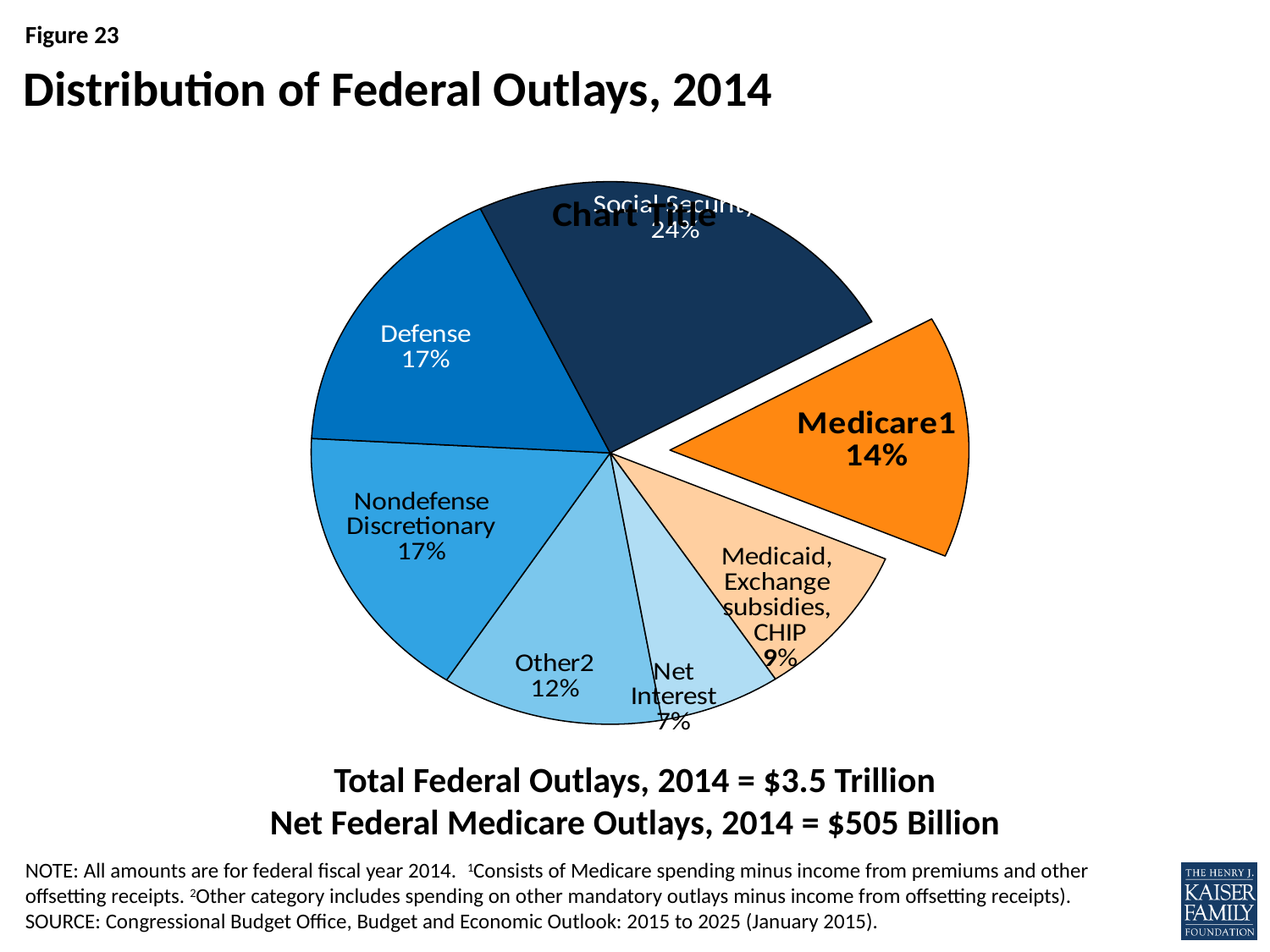
How many slices does the pie chart have? 7 What share of federal outlays is labeled Other? 12% Which slice is pulled out from the rest of the pie? Medicare What percentage is shown for Medicaid, Exchange subsidies, CHIP? 9% Which is larger, the share for Medicare or the share for Other? Medicare What kind of chart is shown on the slide? pie chart Which category has the smallest share of federal outlays? Net Interest What percentage of federal outlays goes to Defense? 17% What is the share for Net Interest? 7% What share of federal outlays does Medicare account for? 14% What is the difference between the Social Security share and the Medicare share? 10% Which category has the largest share of federal outlays? Social Security